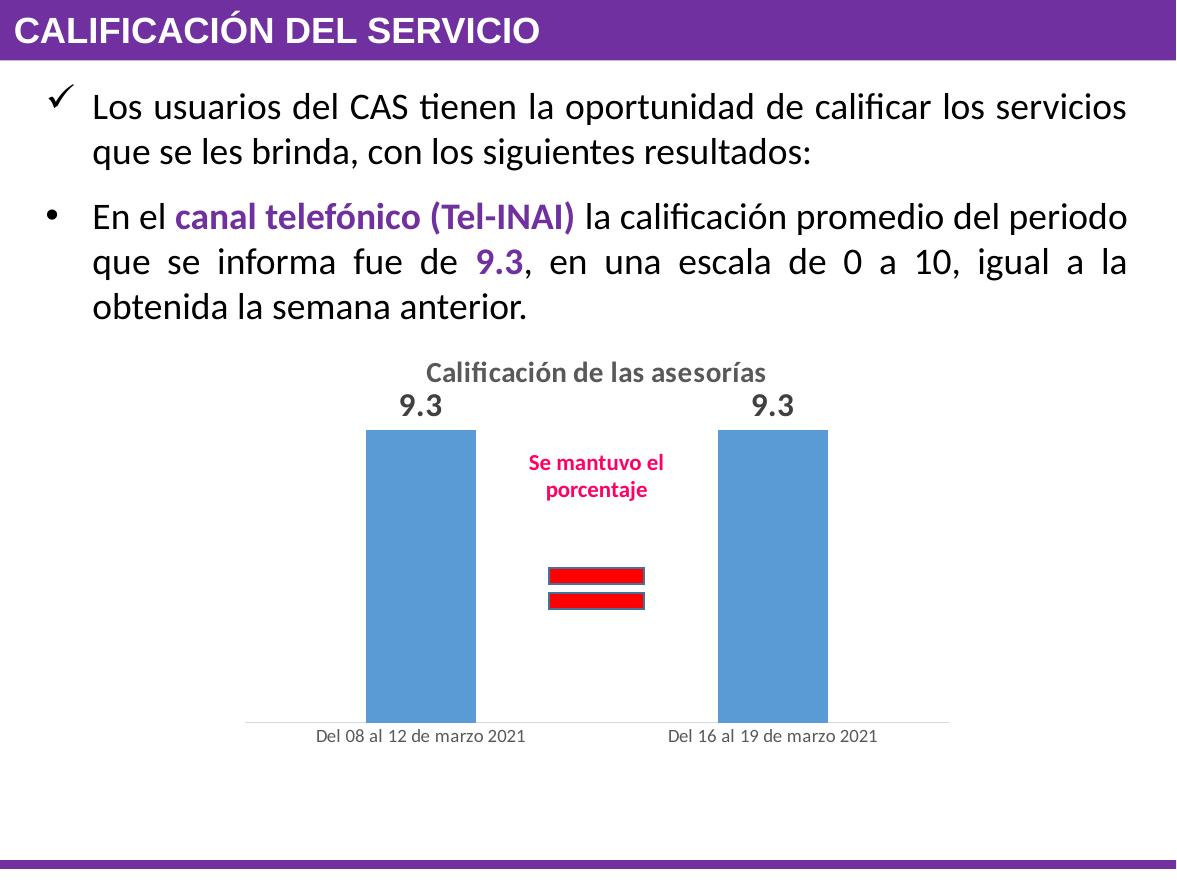
What is the title of the chart on the slide? Calificación de las asesorías What is the difference between the values for 'Del 08 al 12 de marzo 2021' and 'Del 16 al 19 de marzo 2021'? 0 What is the value for 'Del 16 al 19 de marzo 2021' in the chart 'Calificación de las asesorías'? 9.3 What kind of chart is 'Calificación de las asesorías'? Bar chart How many categories are shown in the chart 'Calificación de las asesorías'? 2 What text is written between the two bars of the chart? Se mantuvo el porcentaje What is the value for 'Del 08 al 12 de marzo 2021' in the chart 'Calificación de las asesorías'? 9.3 Do the values rise, fall or stay the same from 'Del 08 al 12 de marzo 2021' to 'Del 16 al 19 de marzo 2021'? Stay the same